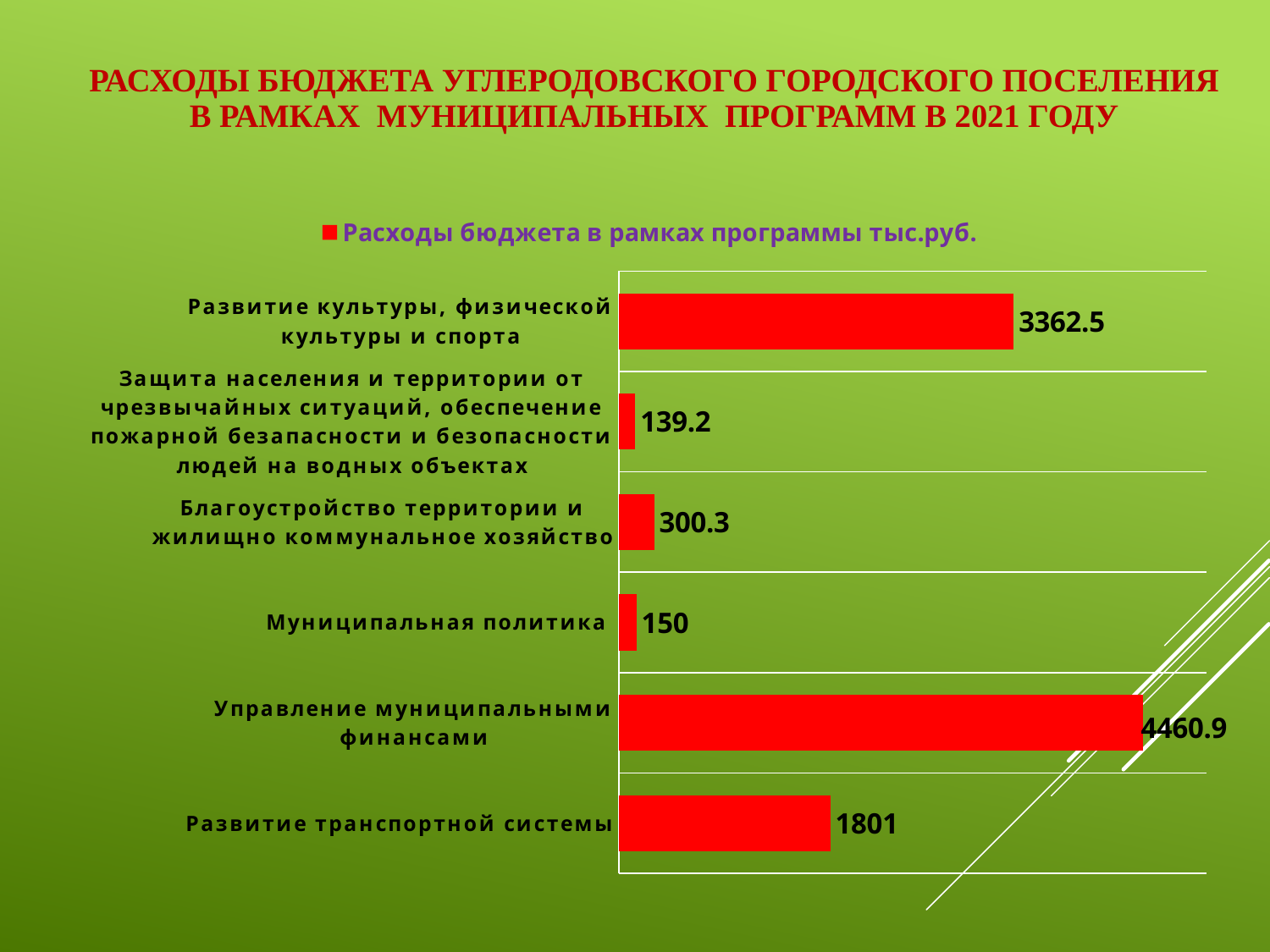
What is the legend entry of the chart? Расходы бюджета в рамках программы тыс.руб. Which category has the highest value? Управление муниципальными финансами What is the value for «Развитие культуры, физической культуры и спорта»? 3362.5 What is the value for «Управление муниципальными финансами»? 4460.9 What is the value for «Развитие транспортной системы»? 1801 How many categories are shown in the chart? 6 What is the value for «Муниципальная политика»? 150 What is the difference between the values for «Благоустройство территории и жилищно коммунальное хозяйство» and «Защита населения и территории от чрезвычайных ситуаций...»? 161.1 What is the difference between the values for «Управление муниципальными финансами» and «Развитие культуры, физической культуры и спорта»? 1098.4 Which is larger: the value for «Развитие транспортной системы» or the value for «Благоустройство территории и жилищно коммунальное хозяйство»? Развитие транспортной системы Which category has the lowest value? Защита населения и территории от чрезвычайных ситуаций, обеспечение пожарной безапасности и безопасности людей на водных объектах What kind of chart is shown on the slide? Bar chart